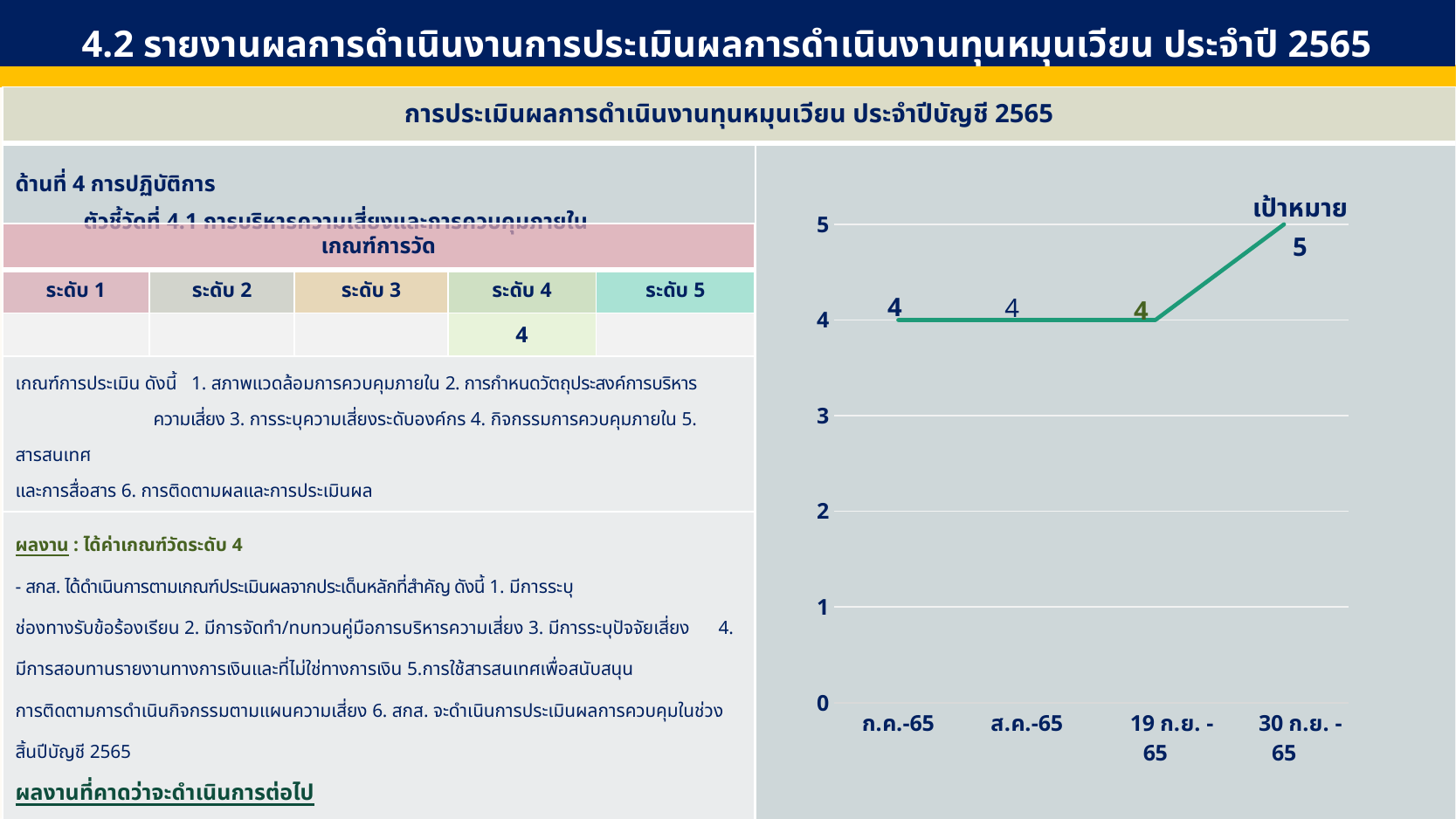
What is the value plotted for ก.ค.-65? 4 What is the value plotted for ส.ค.-65? 4 What is the value plotted for 30 ก.ย.-65? 5 Which is larger, the value for ส.ค.-65 or the value for 30 ก.ย.-65? 30 ก.ย.-65 What is the difference between the value for 30 ก.ย.-65 and the value for 19 ก.ย.-65? 1 How many data points are plotted on the line chart? 4 What is the value plotted for 19 ก.ย.-65? 4 What is the maximum value shown on the y-axis of the line chart? 5 What type of chart is shown on the right side of the slide? line chart Does the line rise, fall, or stay flat between ก.ค.-65 and 19 ก.ย.-65? stays flat What label is written above the last point of the line chart? เป้าหมาย Which x-axis category has the highest value on the line chart? 30 ก.ย.-65